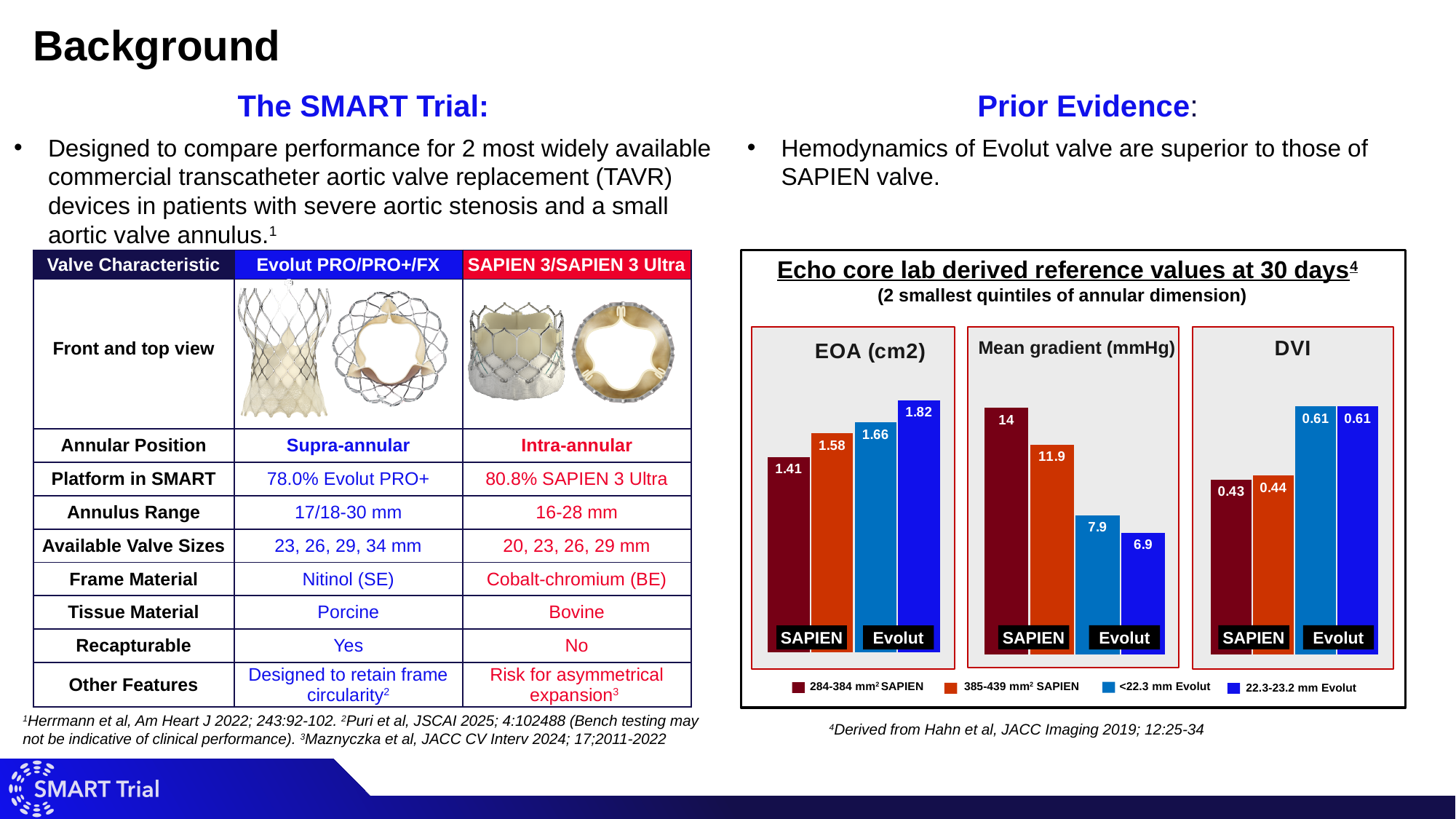
In the Mean gradient (mmHg) chart, which bar has the lowest value? 22.3-23.2 mm Evolut In the EOA (cm2) chart, what is the value for the 22.3-23.2 mm Evolut bar? 1.82 In the Mean gradient (mmHg) chart, what is the value for the 385-439 mm² SAPIEN bar? 11.9 In the DVI chart, what is the difference between the 22.3-23.2 mm Evolut bar and the 284-384 mm² SAPIEN bar? 0.18 In the Mean gradient (mmHg) chart, which is larger: the <22.3 mm Evolut bar or the 385-439 mm² SAPIEN bar? 385-439 mm² SAPIEN What kind of chart is the EOA (cm2) chart? Bar chart In the Mean gradient (mmHg) chart, which bar has the highest value? 284-384 mm² SAPIEN In the EOA (cm2) chart, what is the value for the 284-384 mm² SAPIEN bar? 1.41 How many series does the legend below the charts list? 4 What is the title of the chart panel on the right side of the slide? Echo core lab derived reference values at 30 days In the DVI chart, what is the value for the <22.3 mm Evolut bar? 0.61 In the EOA (cm2) chart, what is the difference between the 22.3-23.2 mm Evolut bar and the 284-384 mm² SAPIEN bar? 0.41